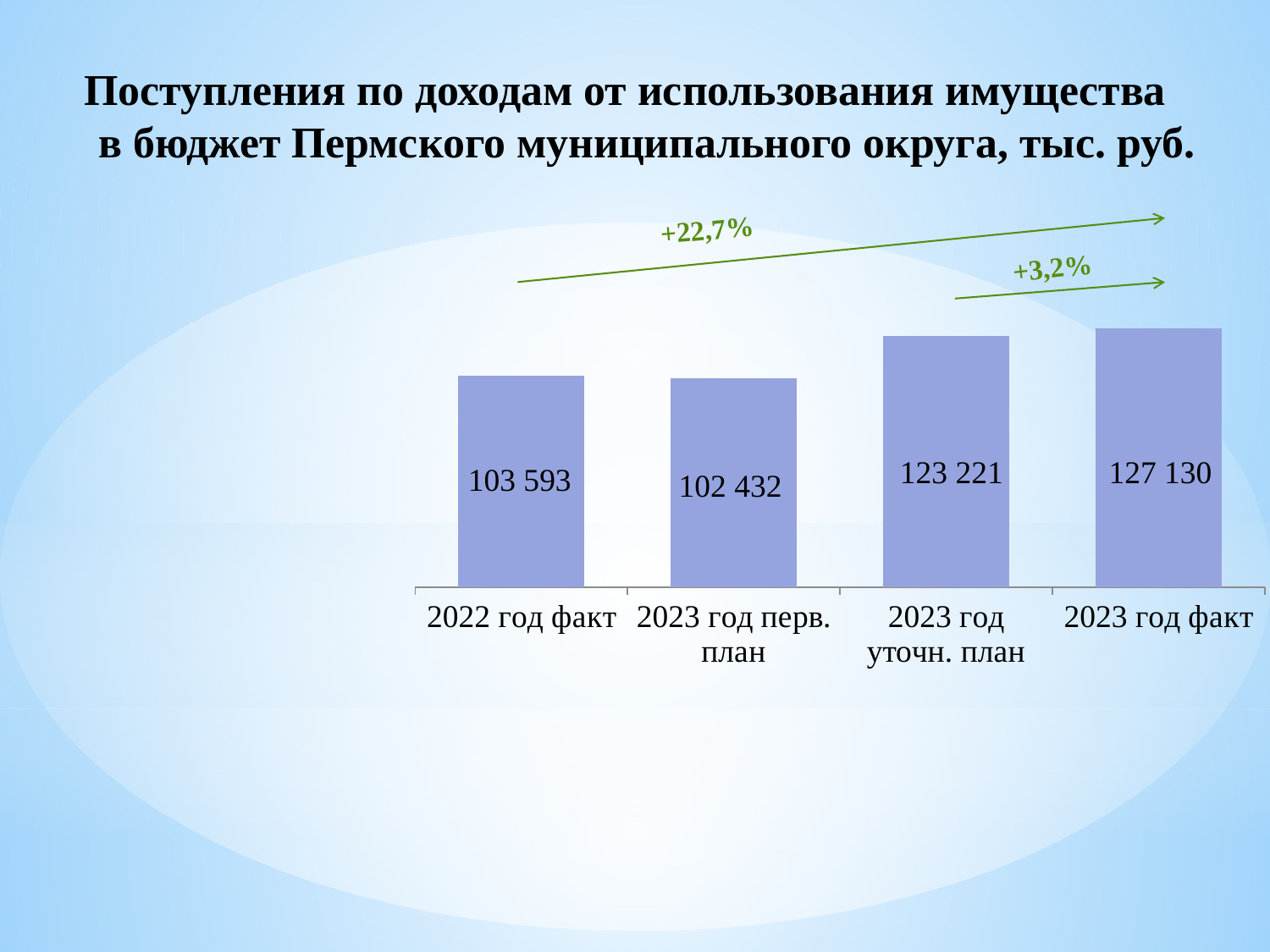
What is the value for 2023 год уточн. план? 123 221 How many categories are shown in the chart? 4 What is the value for 2023 год факт? 127 130 What is the difference between the values for 2023 год факт and 2022 год факт? 23 537 What is the difference between the values for 2023 год уточн. план and 2023 год перв. план? 20 789 Which is larger, the value for 2022 год факт or the value for 2023 год перв. план? 2022 год факт Which category has the lowest value? 2023 год перв. план What kind of chart is shown on the slide? bar chart What is the value for 2022 год факт? 103 593 What percentage change is annotated between 2023 год уточн. план and 2023 год факт? +3,2% Which category has the highest value? 2023 год факт What is the value for 2023 год перв. план? 102 432